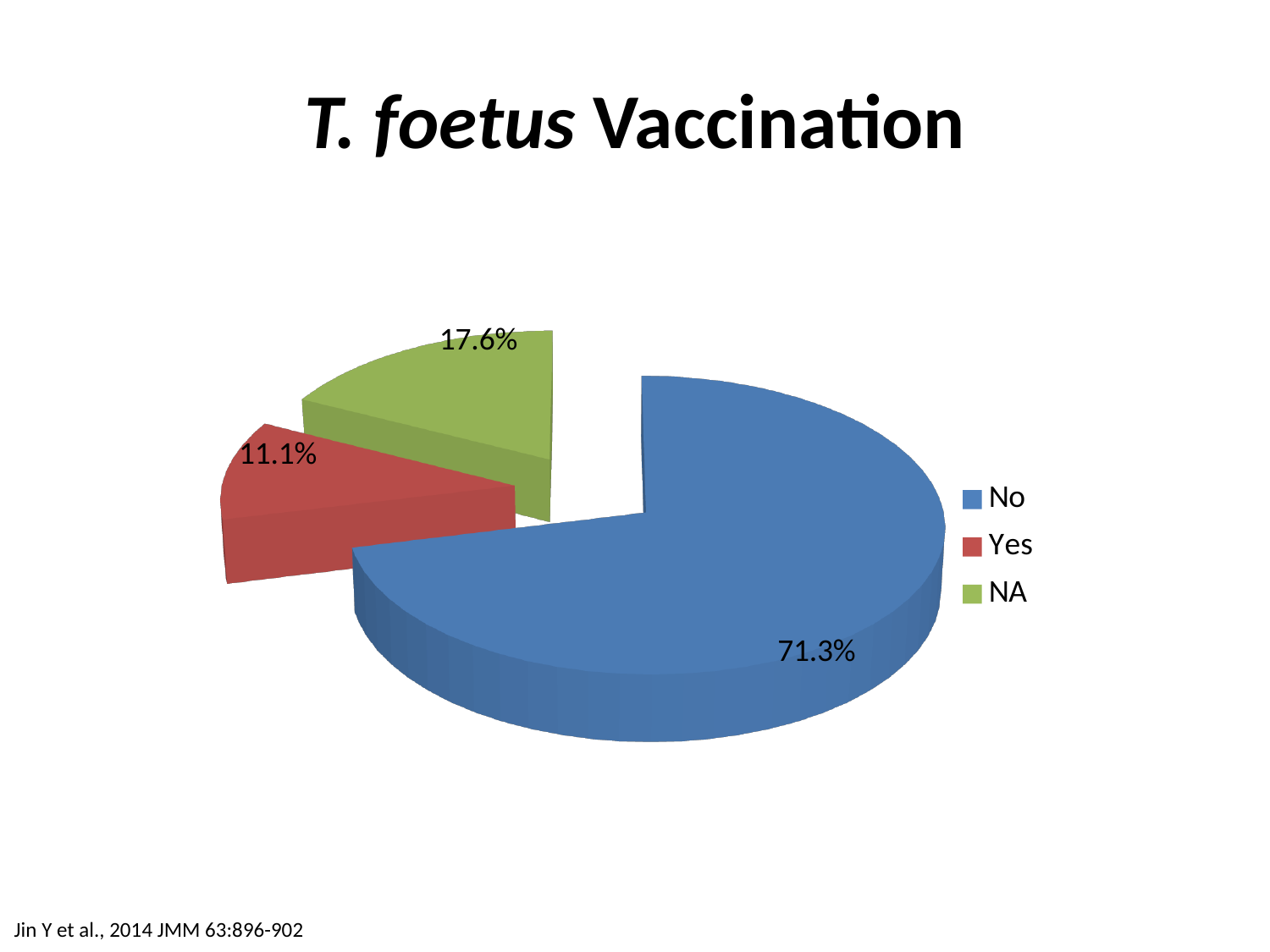
What colour is the "Yes" slice in the pie chart? Red Which is larger, the share for "Yes" or the share for "NA"? NA What is the title of the chart? T. foetus Vaccination Which category has the smallest share of the pie? Yes What percentage of the pie is labelled "Yes"? 11.1% What is the difference in percentage points between the "No" share and the "NA" share? 53.7 Which category has the largest share of the pie? No What is the difference in percentage points between the "NA" share and the "Yes" share? 6.5 How many categories does the pie chart show? 3 What percentage of the pie is labelled "NA"? 17.6% What kind of chart is shown on the slide? Pie chart What percentage of the pie is labelled "No"? 71.3%